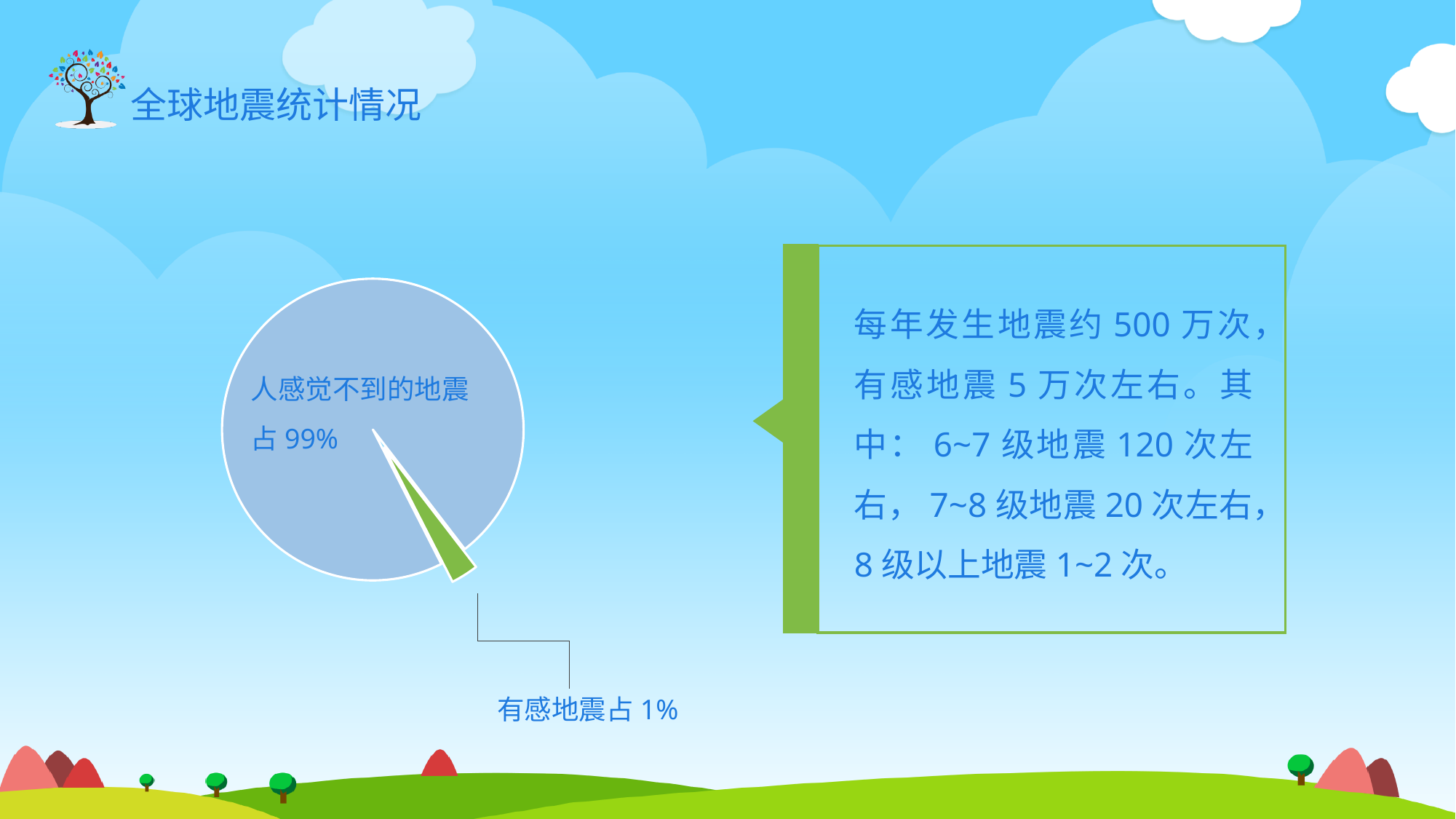
How many slices does the pie chart have? 2 Which slice of the pie chart is the smallest? 有感地震 What share of the pie does 人感觉不到的地震 account for? 99% What colour is the 有感地震 slice in the pie chart? green What is the difference in percentage points between the 人感觉不到的地震 slice and the 有感地震 slice? 98 What is the title of the slide containing the pie chart? 全球地震统计情况 Which is larger in the pie chart, 人感觉不到的地震 or 有感地震? 人感觉不到的地震 Which slice of the pie chart is the largest? 人感觉不到的地震 What share of the pie does 有感地震 account for? 1% What kind of chart is shown on the slide? pie chart